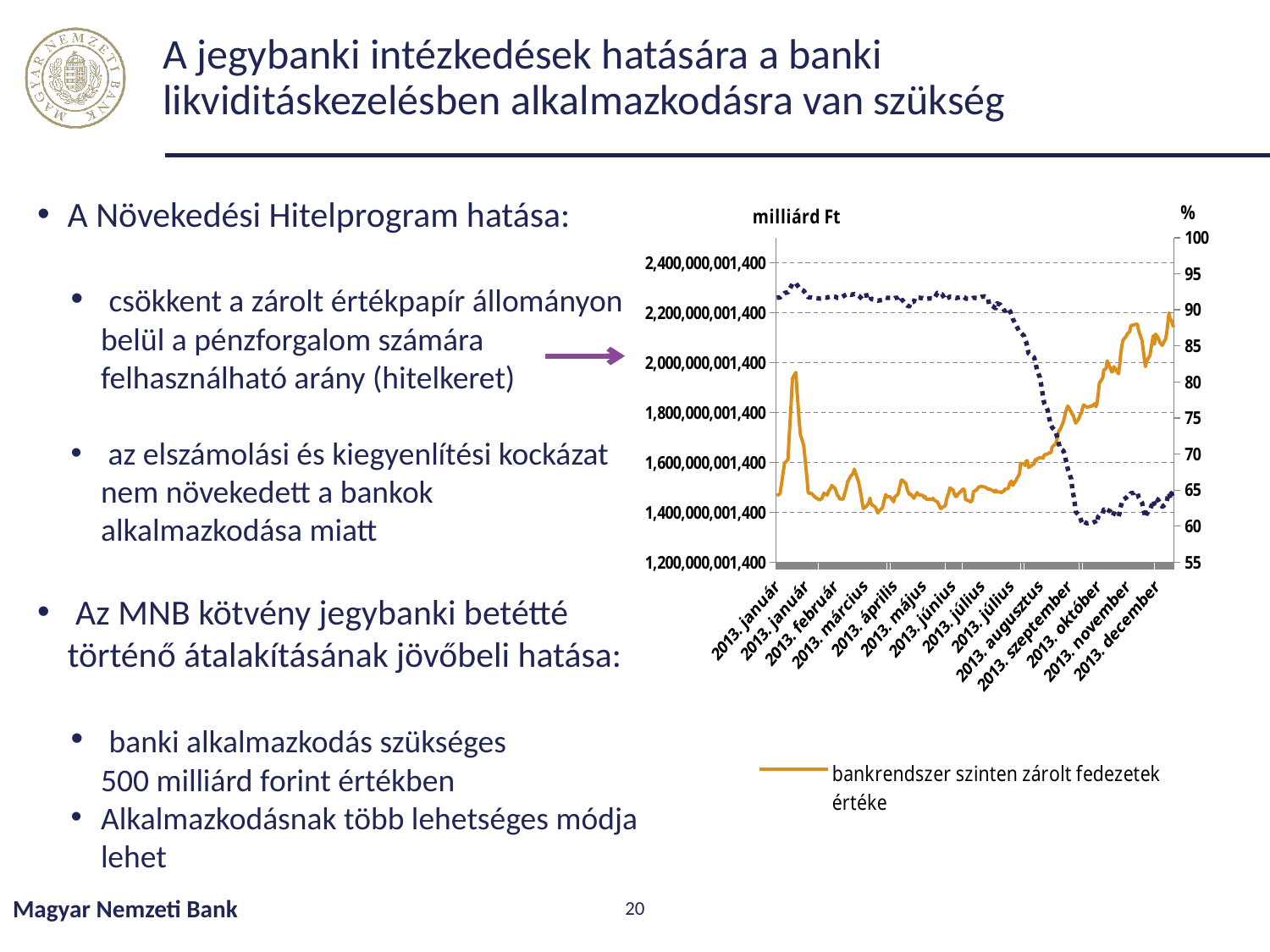
How many series does the chart's legend list? 1 Is the value of the orange line at 2013. december greater or less than 2,000,000,001,400? greater Is the value of the orange line at 2013. április greater or less than 1,600,000,001,400? less Is the value of the dotted line at 2013. január greater or less than 85 on the right axis? greater What kind of chart is shown on the slide? line chart What unit is shown above the left axis of the chart? milliárd Ft Does the dotted line rise or fall overall from 2013. január to 2013. december? fall Does the orange line (bankrendszer szinten zárolt fedezetek értéke) rise or fall overall from 2013. január to 2013. december? rise What is the legend entry for the orange line? bankrendszer szinten zárolt fedezetek értéke